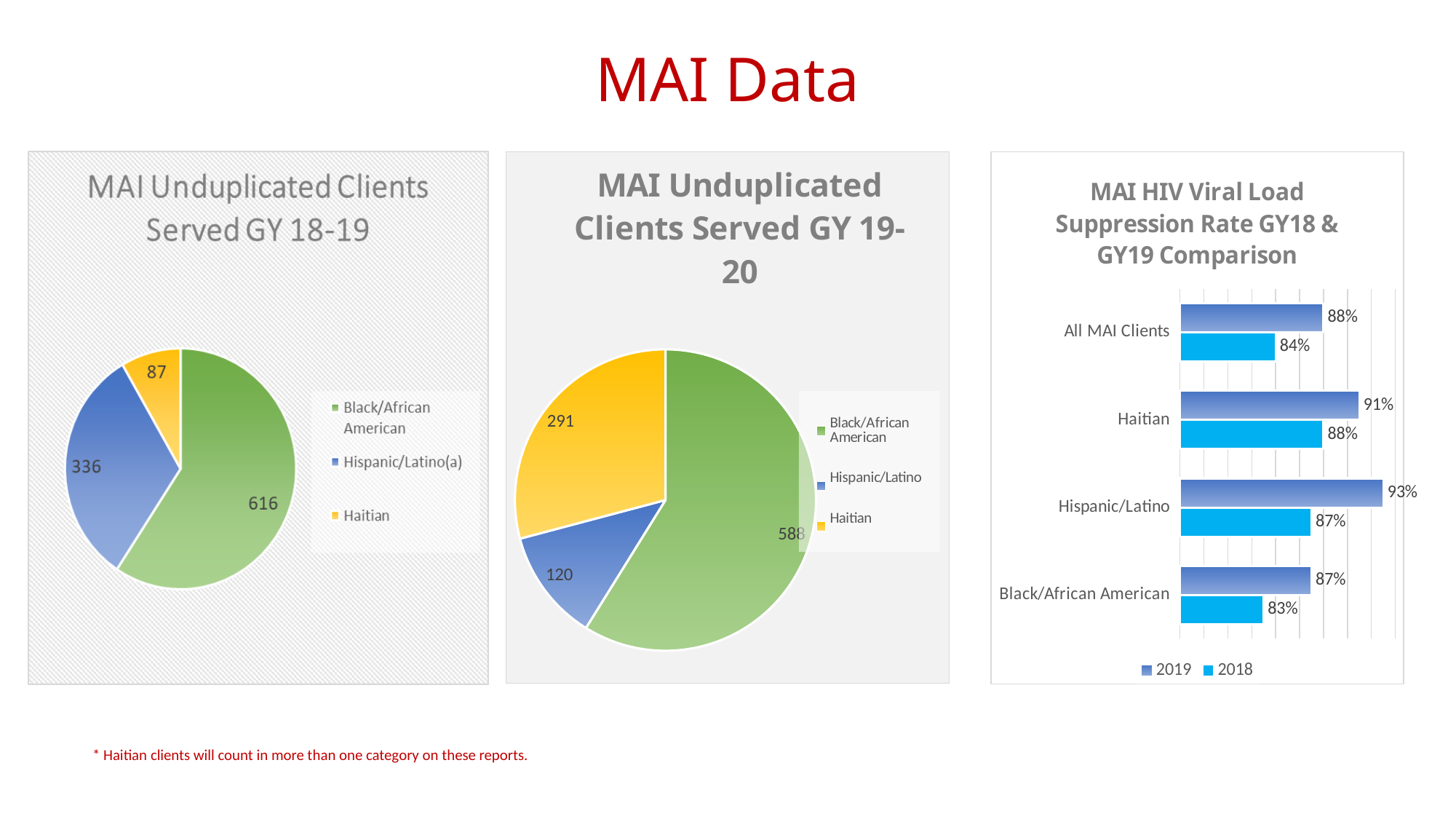
How many series does the legend of the 'MAI HIV Viral Load Suppression Rate GY18 & GY19 Comparison' chart list? 2 In the 'MAI Unduplicated Clients Served GY 19-20' pie chart, what is the value for Haitian? 291 How many categories does the 'MAI Unduplicated Clients Served GY 19-20' pie chart show? 3 In the 'MAI Unduplicated Clients Served GY 18-19' pie chart, what is the difference between the Hispanic/Latino(a) and Haitian values? 249 In the 'MAI HIV Viral Load Suppression Rate GY18 & GY19 Comparison' chart, what is the difference between the 2019 and 2018 values for All MAI Clients? 4% In the 'MAI Unduplicated Clients Served GY 19-20' pie chart, which is larger, the Hispanic/Latino slice or the Haitian slice? Haitian In the 'MAI HIV Viral Load Suppression Rate GY18 & GY19 Comparison' chart, what is the 2019 value for Hispanic/Latino? 93% In the 'MAI Unduplicated Clients Served GY 18-19' pie chart, which category has the smallest slice? Haitian In the 'MAI Unduplicated Clients Served GY 19-20' pie chart, which category has the largest slice? Black/African American In the 'MAI Unduplicated Clients Served GY 18-19' pie chart, how many Black/African American clients were served? 616 What kind of chart is the 'MAI HIV Viral Load Suppression Rate GY18 & GY19 Comparison' chart? Bar chart In the 'MAI HIV Viral Load Suppression Rate GY18 & GY19 Comparison' chart, what is the 2018 value for Black/African American? 83%